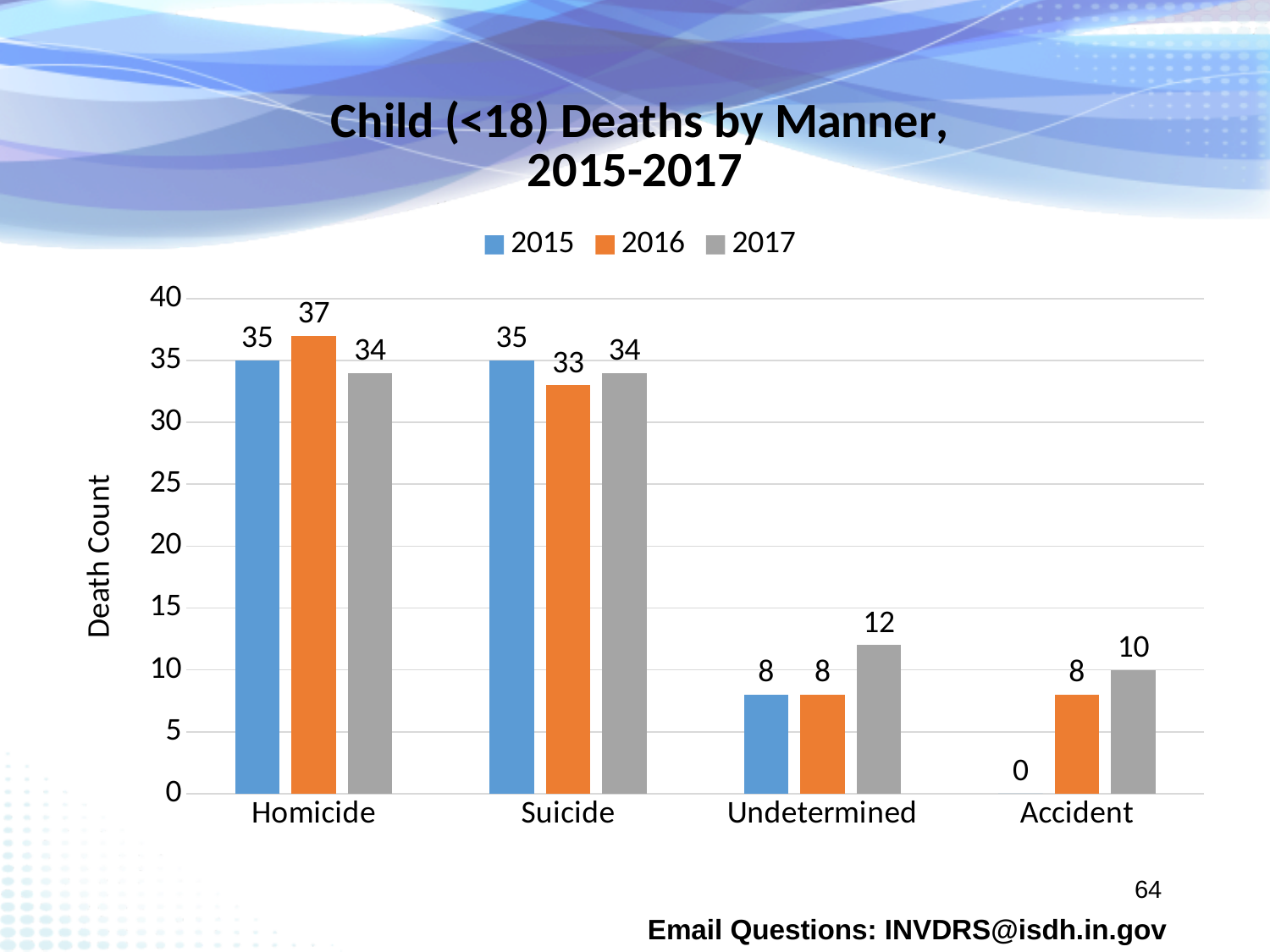
Which manner of death has the highest count in 2016? Homicide Which is larger, the Suicide death count in 2016 or in 2017? 2017 How many manner-of-death categories are shown on the x axis? 4 What is the title of the chart? Child (<18) Deaths by Manner, 2015-2017 What is the death count for Undetermined in 2017? 12 What kind of chart is shown on the slide? Bar chart What is the difference between the Homicide death counts in 2016 and 2017? 3 What is the death count for Accident in 2015? 0 What is the death count for Suicide in 2015? 35 What is the death count for Homicide in 2016? 37 How many series does the legend list? 3 Which manner of death has the lowest count in 2017? Accident